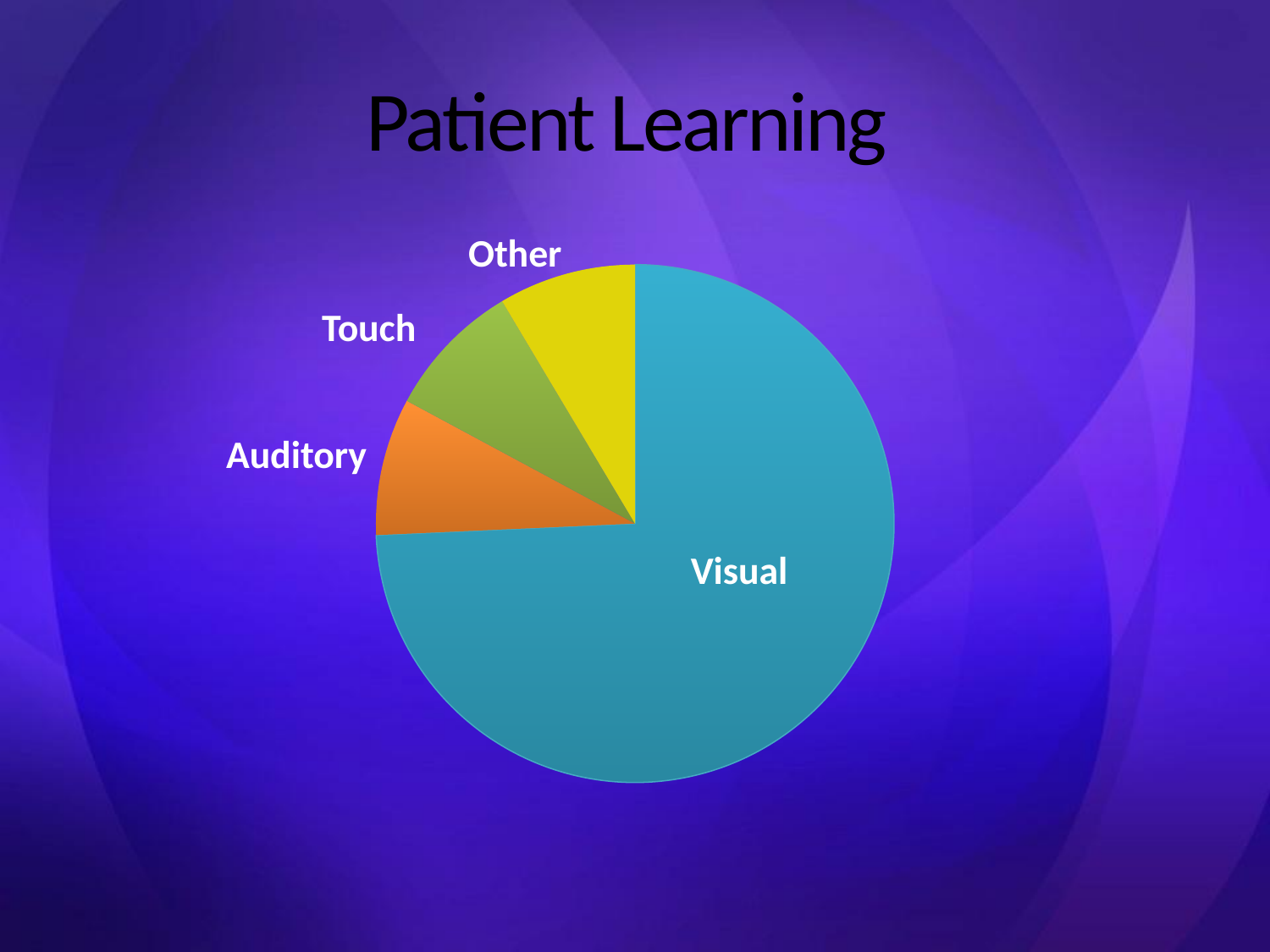
Which slice is larger, Visual or Auditory? Visual What is the title of the chart on the slide? Patient Learning Which slice is larger, Visual or Touch? Visual Which category has the largest slice of the pie? Visual Which slice is larger, Visual or Other? Visual What colour is the Visual slice? Blue Which categories are shown in the pie chart? Visual, Auditory, Touch, Other How many slices does the pie chart have? 4 What kind of chart is shown on the slide? Pie chart